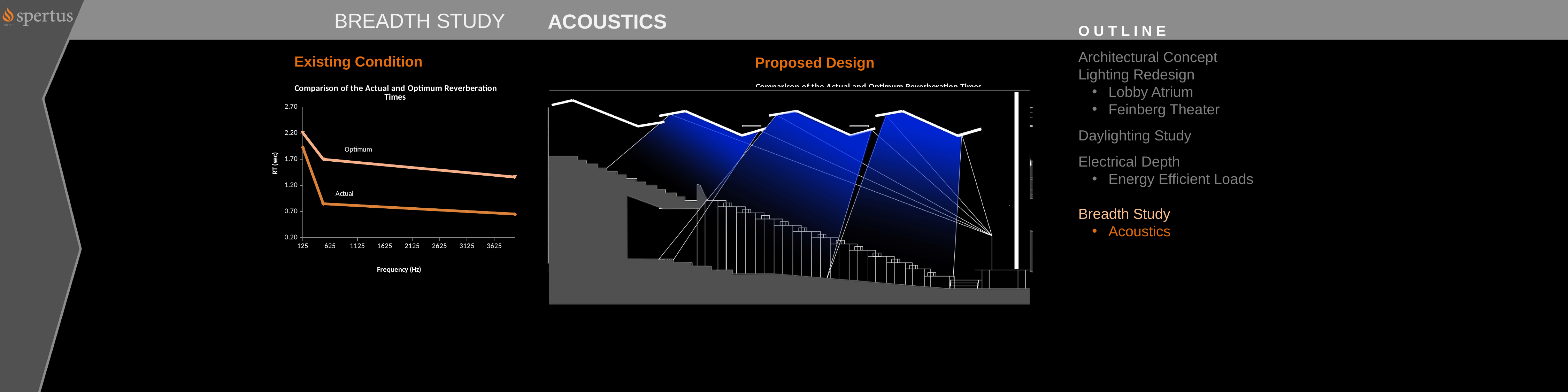
On the Existing Condition chart, how many frequency tick labels are shown on the x axis? 8 On the Existing Condition chart, do the Actual values rise or fall as frequency increases? fall On the Existing Condition chart, how many data series are plotted? 2 On the Existing Condition chart, what is the label of the vertical axis? RT (sec) On the Existing Condition chart, at 625 Hz, which series has the larger value, Optimum or Actual? Optimum On the Existing Condition chart, is the Optimum value at 125 Hz greater or less than 1.70? greater On the Existing Condition chart, what are the names of the two plotted series? Optimum and Actual On the Existing Condition chart, do the Optimum values rise or fall as frequency increases? fall On the Existing Condition chart, is the Actual value at 3625 Hz greater or less than 1.20? less On the Existing Condition chart, at which frequency is the Actual reverberation time highest? 125 On the Existing Condition chart, is the Actual value at 625 Hz greater or less than 1.20? less On the Existing Condition chart, what kind of chart is shown? line chart